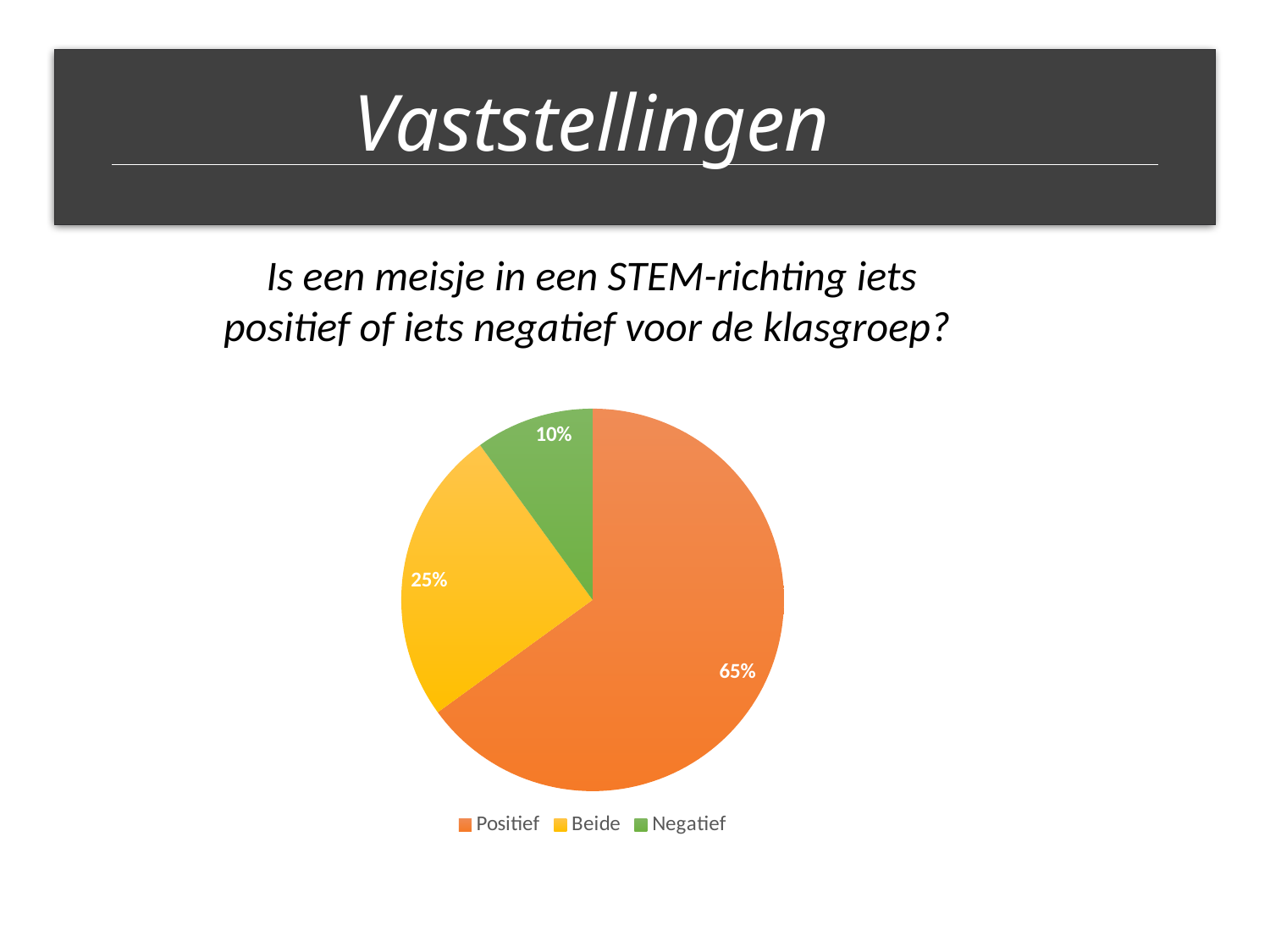
What percentage of the pie chart is labelled Negatief? 10% What is the difference in percentage points between the Beide and Negatief slices? 15 What percentage of the pie chart is labelled Positief? 65% What question is the pie chart answering, according to the text above it? Is een meisje in een STEM-richting iets positief of iets negatief voor de klasgroep? Which category has the largest slice of the pie chart? Positief What percentage of the pie chart is labelled Beide? 25% What kind of chart is shown on the slide? Pie chart How many categories does the pie chart show? 3 What colour is the Negatief slice in the pie chart? Green Which category has the smallest slice of the pie chart? Negatief What is the difference in percentage points between the Positief and Beide slices? 40 Which slice is larger, Beide or Negatief? Beide